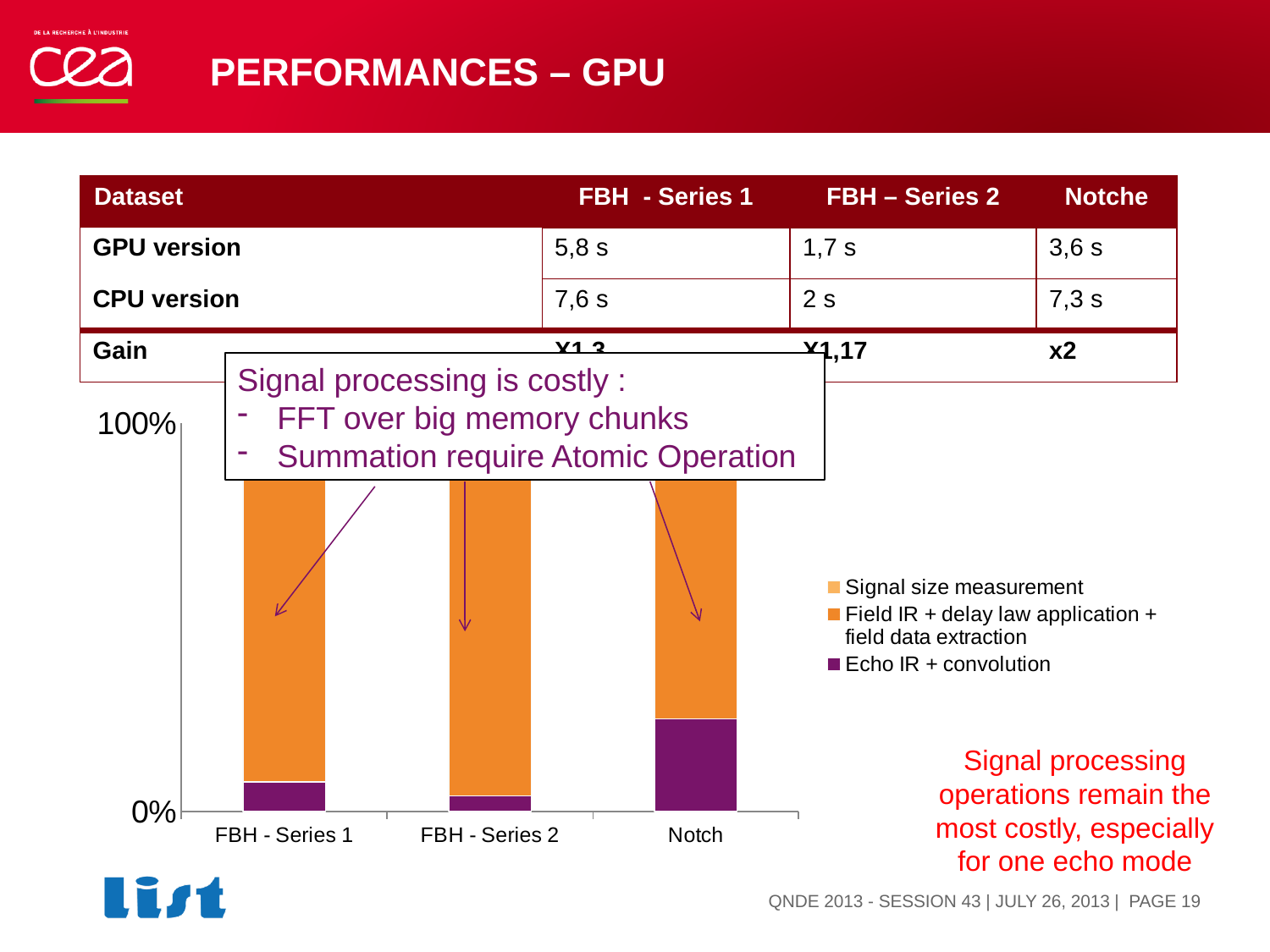
Which legend entry is shown in purple? Echo IR + convolution What kind of chart is shown on the slide? stacked bar chart Which category has the largest Echo IR + convolution segment? Notch Which category has the smallest Echo IR + convolution segment? FBH - Series 2 Is the Echo IR + convolution segment larger for Notch or for FBH - Series 1? Notch What are the category labels on the x axis of the chart? FBH - Series 1, FBH - Series 2, Notch Is the Echo IR + convolution segment larger for FBH - Series 1 or for FBH - Series 2? FBH - Series 1 How many series does the chart's legend list? 3 Which category has the smallest Field IR + delay law application + field data extraction segment? Notch How many categories are shown on the x axis of the chart? 3